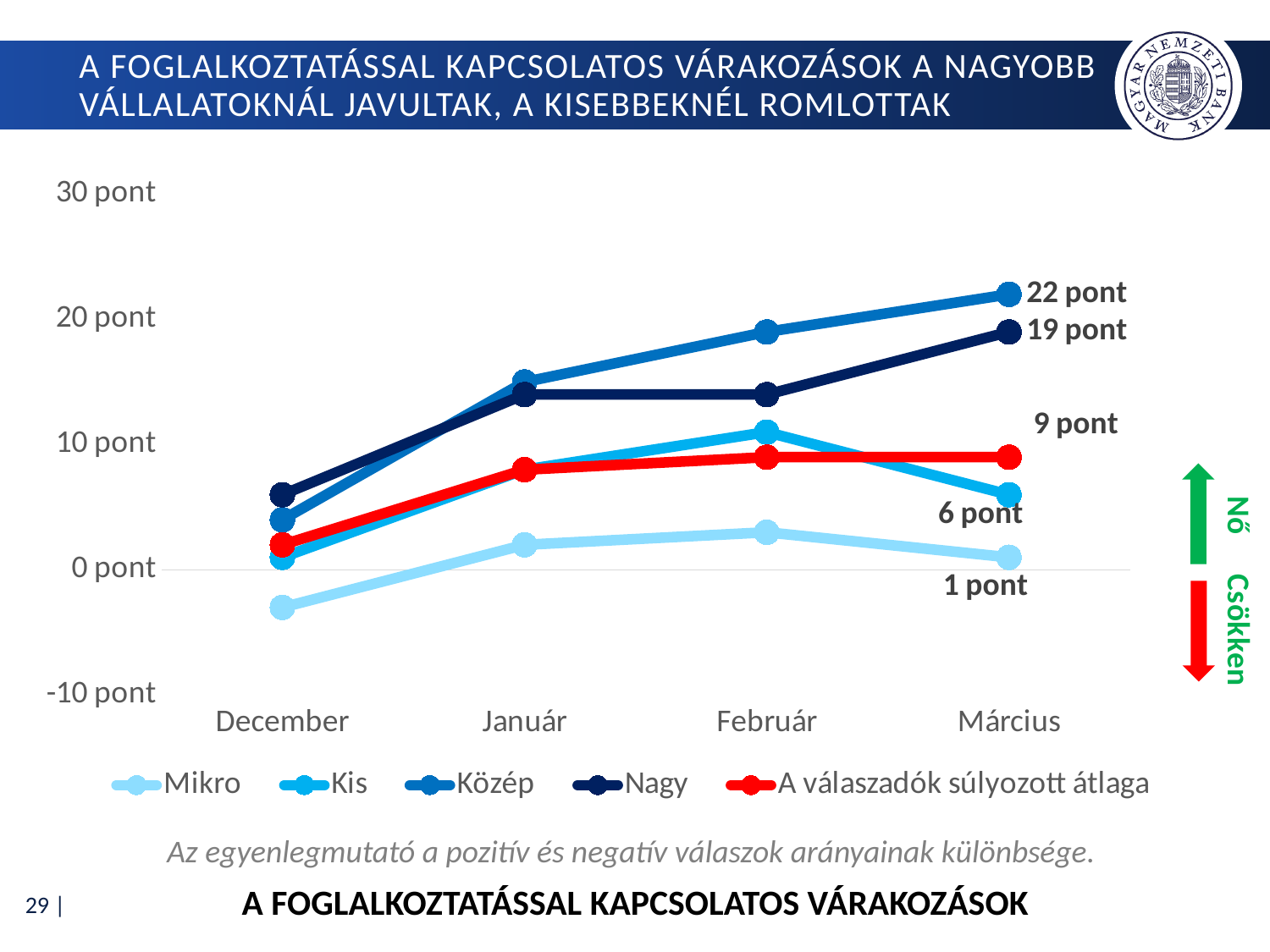
What kind of chart is shown on the slide? line chart Which series has the lowest value in Március? Mikro What is the value for Közép in Március? 22 pont Is the value for Mikro in December greater or less than 0 pont? less What is the difference between Közép and Nagy in Március? 3 pont What is the value for Nagy in Március? 19 pont What is the value for Kis in Március? 6 pont What is the value for Mikro in Március? 1 pont How many series does the legend list? 5 Which series has the highest value in Március? Közép In Március, which is larger: Kis or A válaszadók súlyozott átlaga? A válaszadók súlyozott átlaga Does the Közép series rise or fall from December to Március? rise